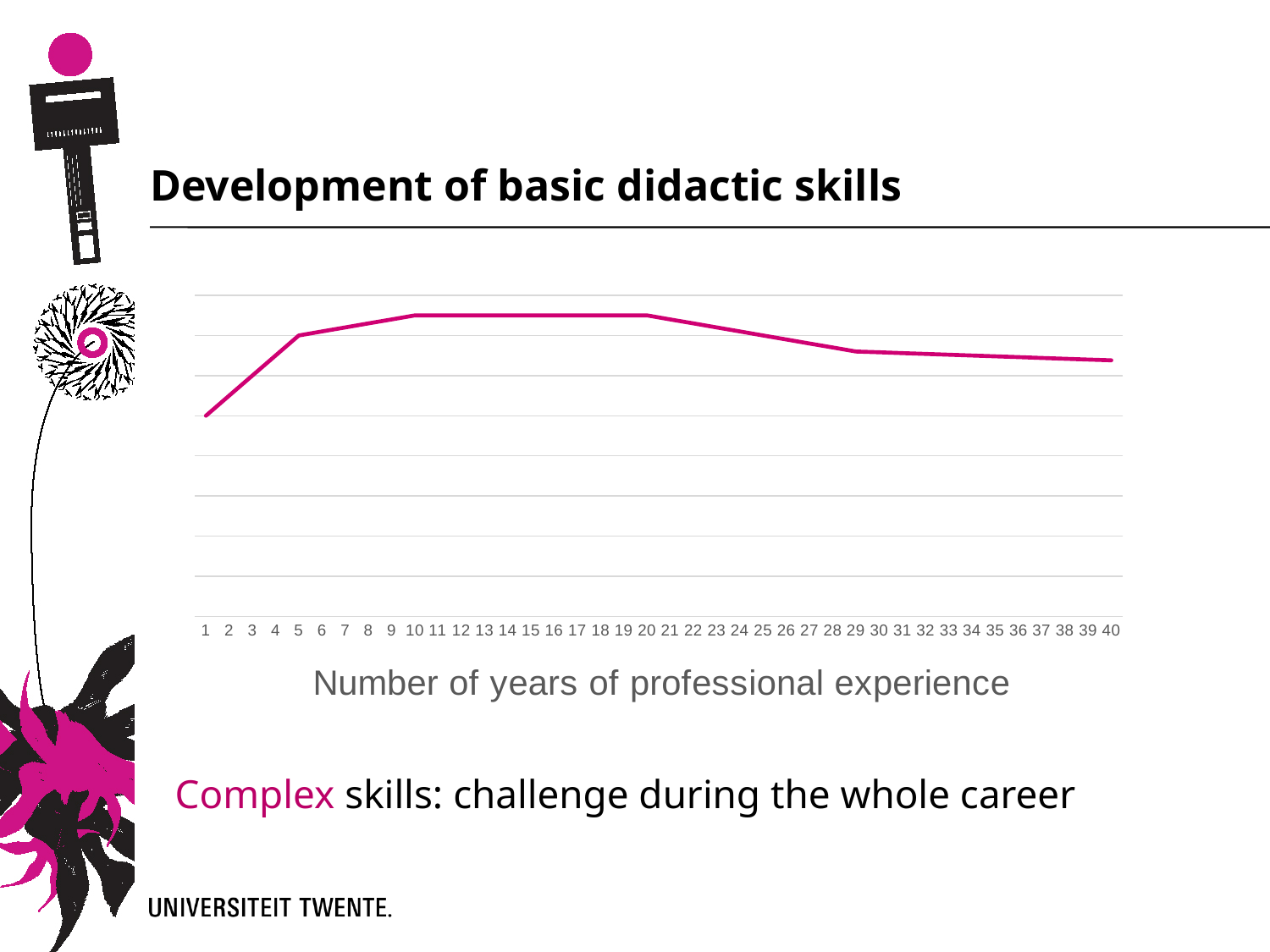
What colour is the line in the chart? pink At which year of professional experience is the line at its lowest? 1 Which is higher on the line, year 20 or year 40? year 20 What is the first x-axis label and the last x-axis label of the chart? 1 and 40 How many lines are plotted in the chart? 1 How many points are labelled along the x axis of the chart? 40 Does the line rise or fall between year 20 and year 40? fall What kind of chart is shown on the slide? line chart Which is higher on the line, year 10 or year 1? year 10 Does the line rise or fall between year 1 and year 10? rise What is the x-axis title of the chart? Number of years of professional experience Which is higher on the line, year 1 or year 40? year 40